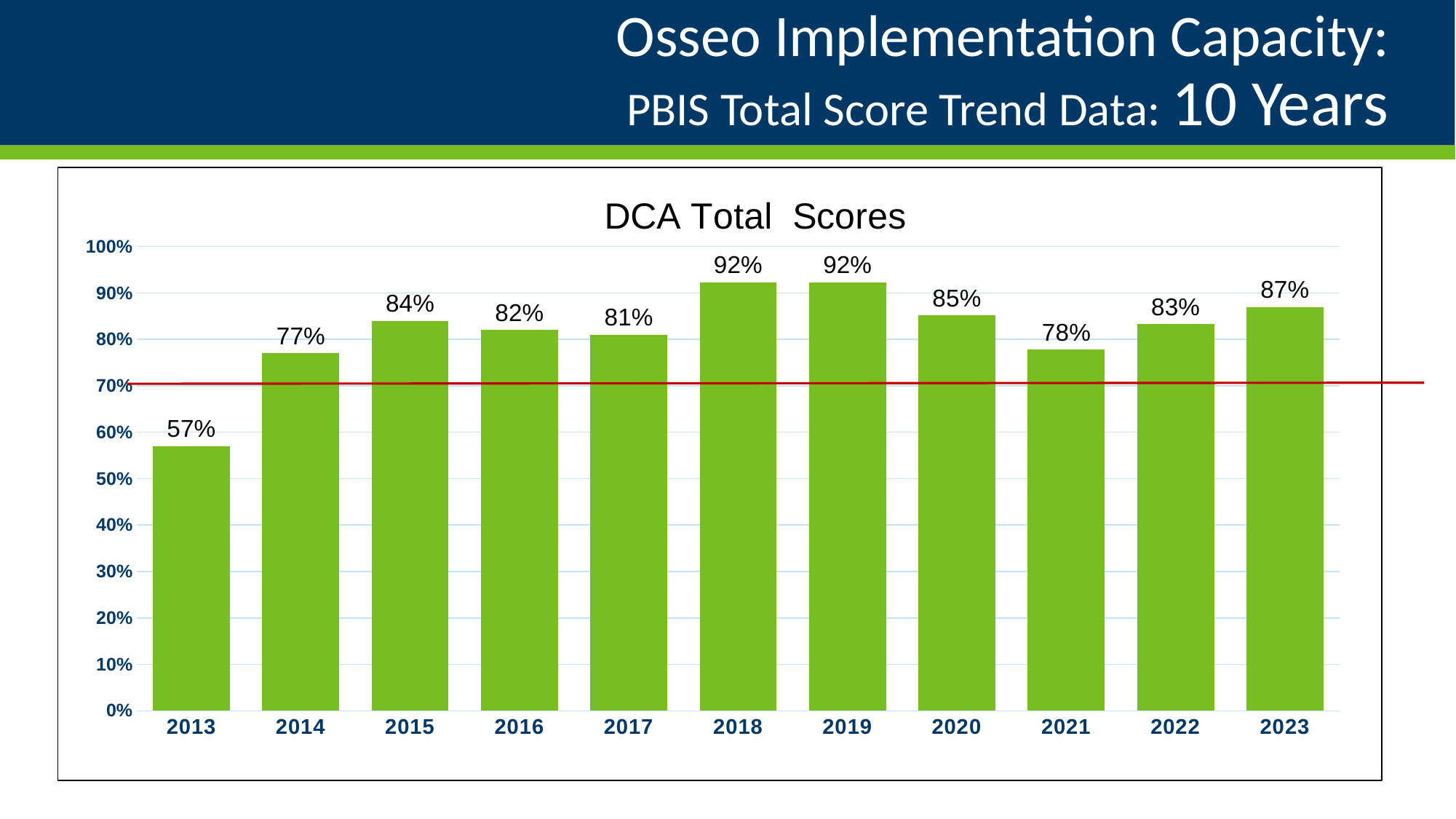
What is the DCA Total Score for 2020? 85% What is the difference between the DCA Total Scores for 2023 and 2013? 30% What is the DCA Total Score for 2013? 57% What is the title of the chart? DCA Total Scores What kind of chart is shown on the slide? Bar chart Is the DCA Total Score for 2021 greater or less than 70%? greater Which years share the highest DCA Total Score? 2018 and 2019 What is the difference between the DCA Total Scores for 2019 and 2021? 14% What is the DCA Total Score for 2023? 87% Which year has a higher DCA Total Score, 2015 or 2022? 2015 Which year has the lowest DCA Total Score? 2013 How many years are shown on the chart? 11